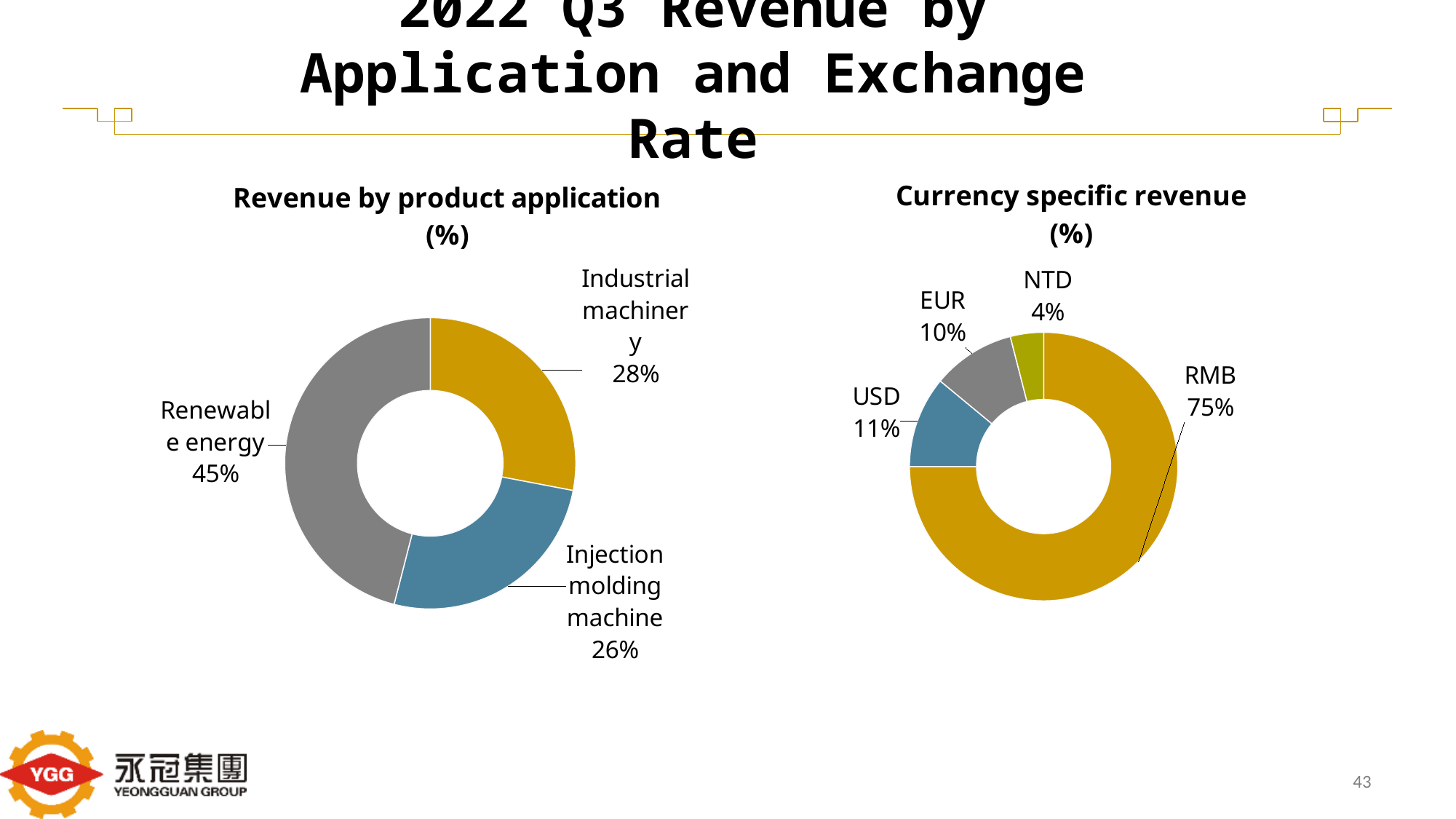
In the 'Revenue by product application (%)' chart, which category has the largest share? Renewable energy In the 'Revenue by product application (%)' chart, what share does Injection molding machine have? 26% In the 'Currency specific revenue (%)' chart, what share does EUR have? 10% In the 'Currency specific revenue (%)' chart, what is the difference between the RMB share and the NTD share? 71% In the 'Revenue by product application (%)' chart, how many categories are shown? 3 In the 'Currency specific revenue (%)' chart, how many currencies are shown? 4 In the 'Currency specific revenue (%)' chart, which currency has the largest share? RMB In the 'Revenue by product application (%)' chart, what share does Renewable energy have? 45% In the 'Currency specific revenue (%)' chart, which currency has the smallest share? NTD What kind of chart is the 'Revenue by product application (%)' chart? Doughnut chart In the 'Currency specific revenue (%)' chart, what share does USD have? 11% In the 'Revenue by product application (%)' chart, what is the difference between the Renewable energy share and the Industrial machinery share? 17%